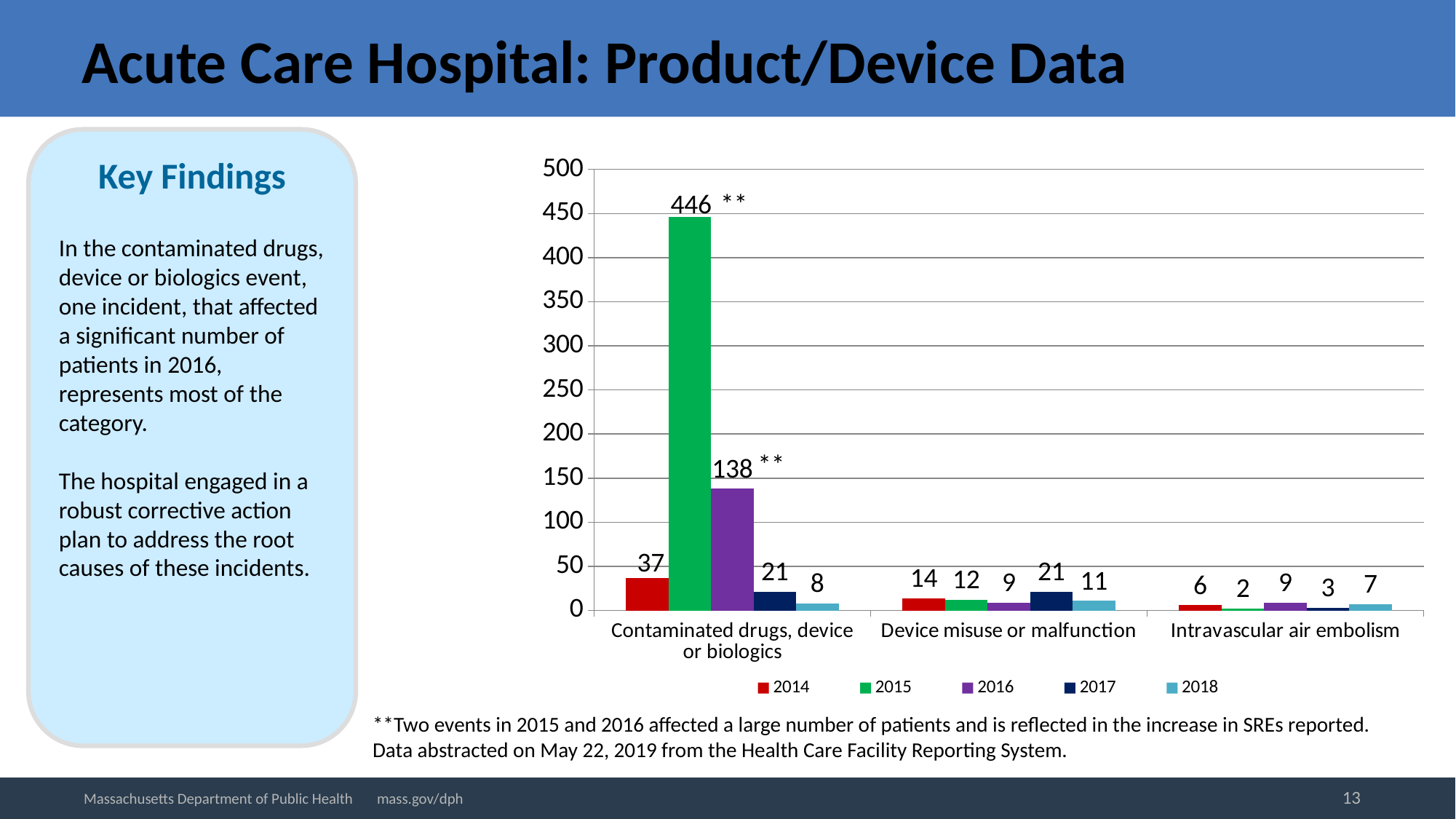
What is the value for 2017 in the Device misuse or malfunction category? 21 What is the difference between the 2015 and 2016 values in the Contaminated drugs, device or biologics category? 308 Which year has the lowest value in the Intravascular air embolism category? 2015 How many categories are shown on the x axis? 3 What kind of chart is shown on the slide? bar chart Which year has the highest value in the Contaminated drugs, device or biologics category? 2015 What colour represents the 2016 series in the chart? purple Which is larger in the Device misuse or malfunction category: the 2014 value or the 2018 value? 2014 Is the value for 2016 in the Contaminated drugs, device or biologics category greater or less than 100? greater What is the value for 2018 in the Intravascular air embolism category? 7 What is the value for 2015 in the Contaminated drugs, device or biologics category? 446 How many series does the legend list? 5